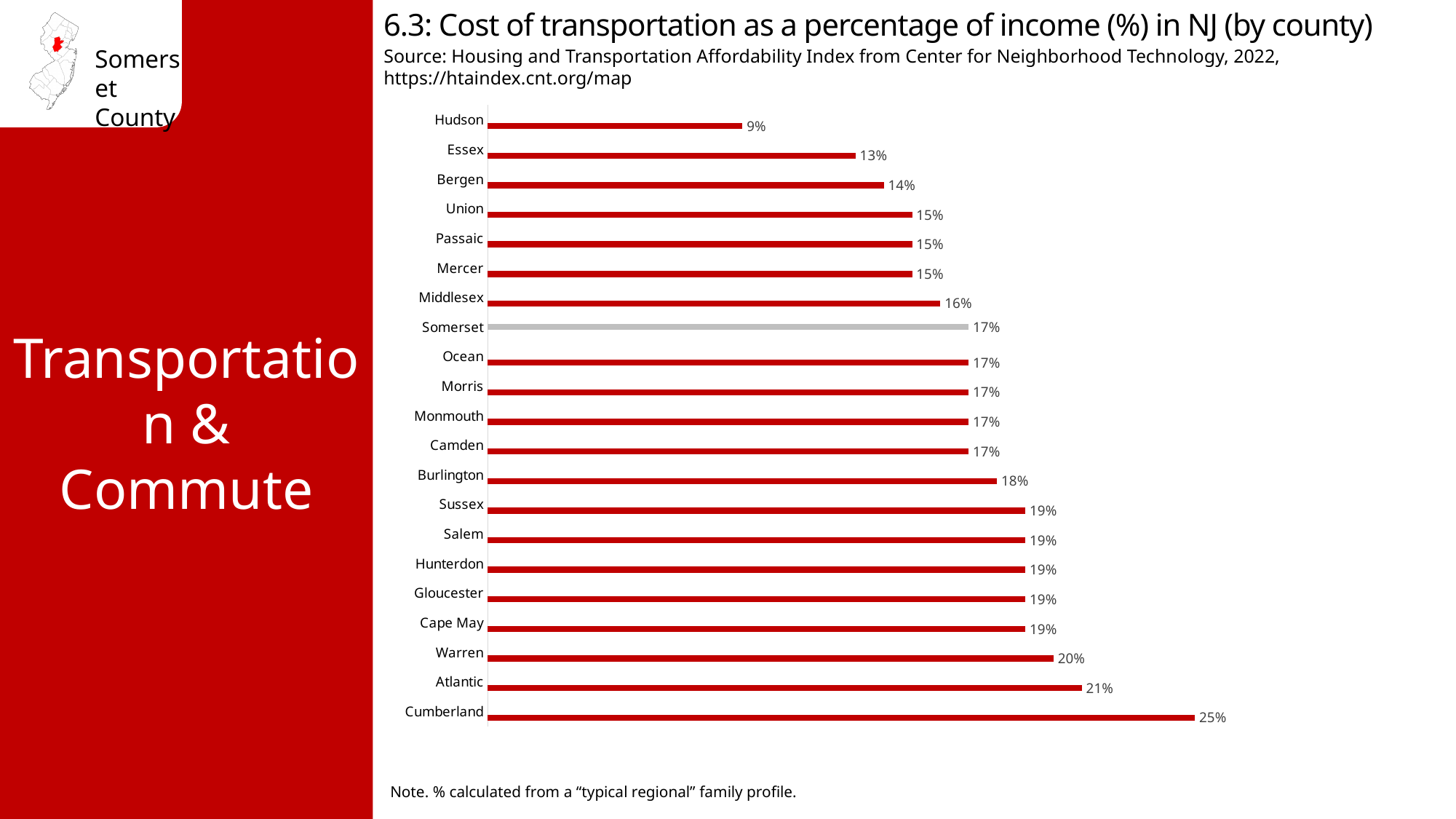
How many counties are shown in the chart? 21 Which county's bar is shown in grey rather than red? Somerset What is the cost of transportation as a percentage of income for Somerset County? 17% Which county has the highest cost of transportation as a percentage of income? Cumberland What is the difference between Warren's and Somerset's cost of transportation as a percentage of income? 3% What is the cost of transportation as a percentage of income for Hudson County? 9% Which county has a higher cost of transportation as a percentage of income, Essex or Burlington? Burlington Which county has the lowest cost of transportation as a percentage of income? Hudson What is the difference between Cumberland's and Hudson's cost of transportation as a percentage of income? 16% Which county has a higher cost of transportation as a percentage of income, Bergen or Middlesex? Middlesex What is the cost of transportation as a percentage of income for Atlantic County? 21% What type of chart is shown on the slide? Bar chart